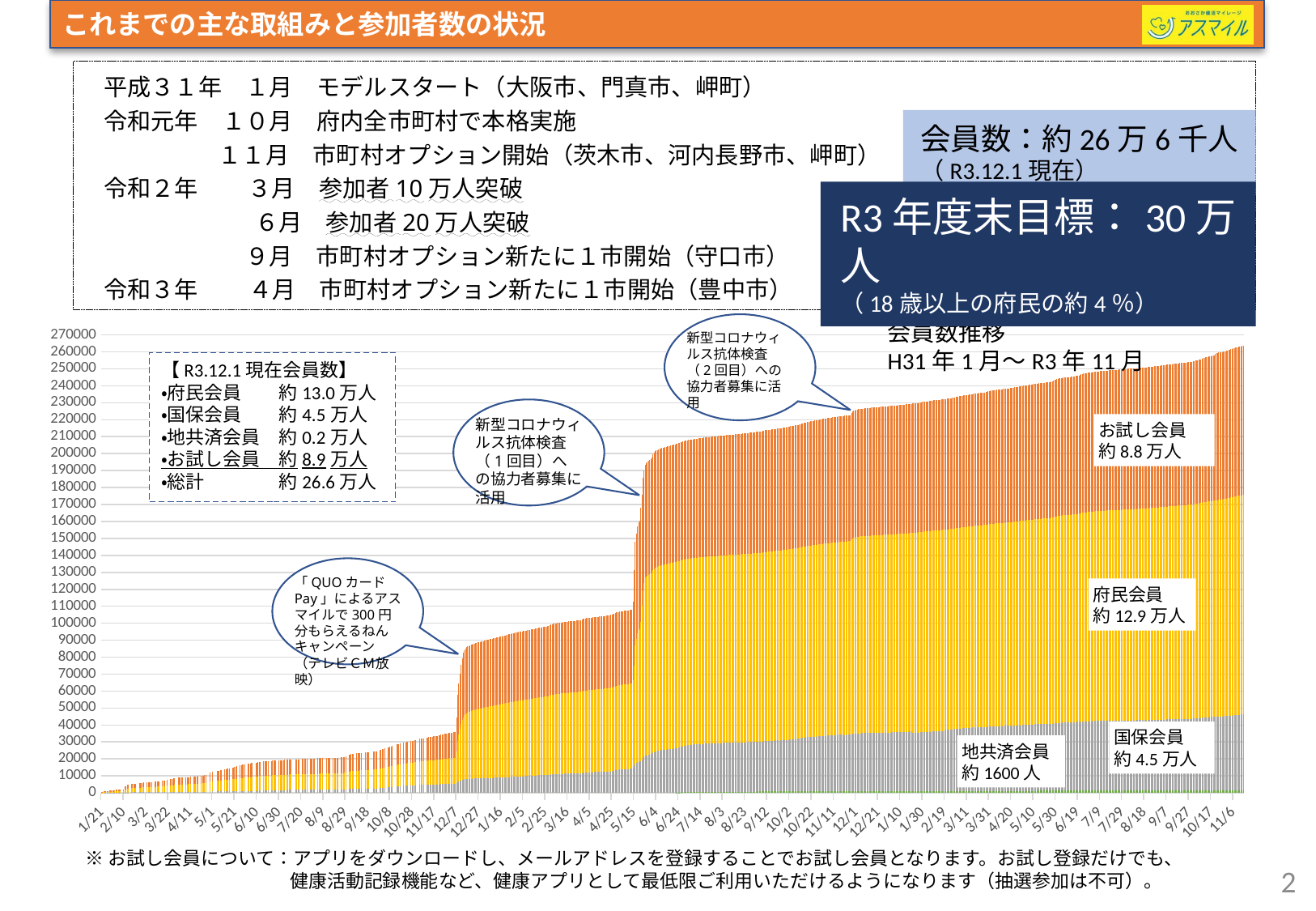
Which member category has the largest number of members in the chart? 府民会員 According to the label on the chart, how many 国保会員 are there? 約4.5万人 Which is larger, お試し会員 or 国保会員? お試し会員 According to the label on the chart, how many 地共済会員 are there? 約1600人 What is the title of the chart? 会員数推移 H31年1月～R3年11月 According to the label on the chart, how many 府民会員 are there? 約12.9万人 According to the label on the chart, how many お試し会員 are there? 約8.8万人 Is the total value of the bar at 7/14 (after the second jump) greater or less than 200000? greater Is the total value of the last bar (11/6) greater or less than 250000? greater Which member category has the smallest number of members in the chart? 地共済会員 Do the total member numbers rise or fall over time along the x axis? Rise What kind of chart is shown on the slide? Stacked bar chart